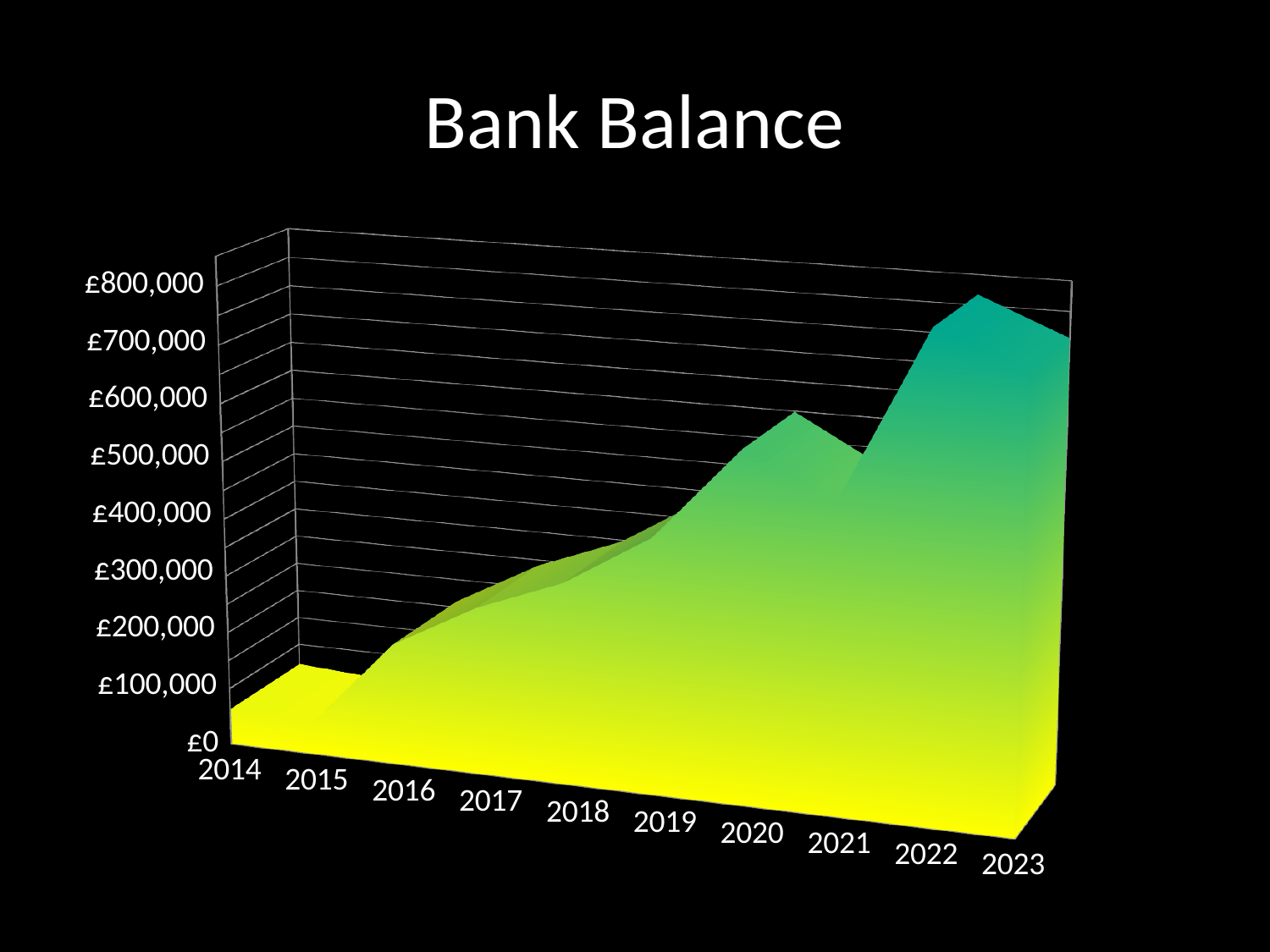
Which year has the larger bank balance, 2020 or 2021? 2020 Is the bank balance for 2014 greater or less than £300,000? less Is the bank balance for 2016 greater or less than £500,000? less Is the bank balance for 2020 greater or less than £300,000? greater How many years are shown on the x axis of the chart? 10 Overall, does the bank balance rise or fall from 2014 to 2023? rise Which year has the highest bank balance? 2022 What is the title of the chart? Bank Balance What is the highest value labelled on the vertical axis? £800,000 Which year has the larger bank balance, 2014 or 2022? 2022 What kind of chart is shown on the slide? area chart